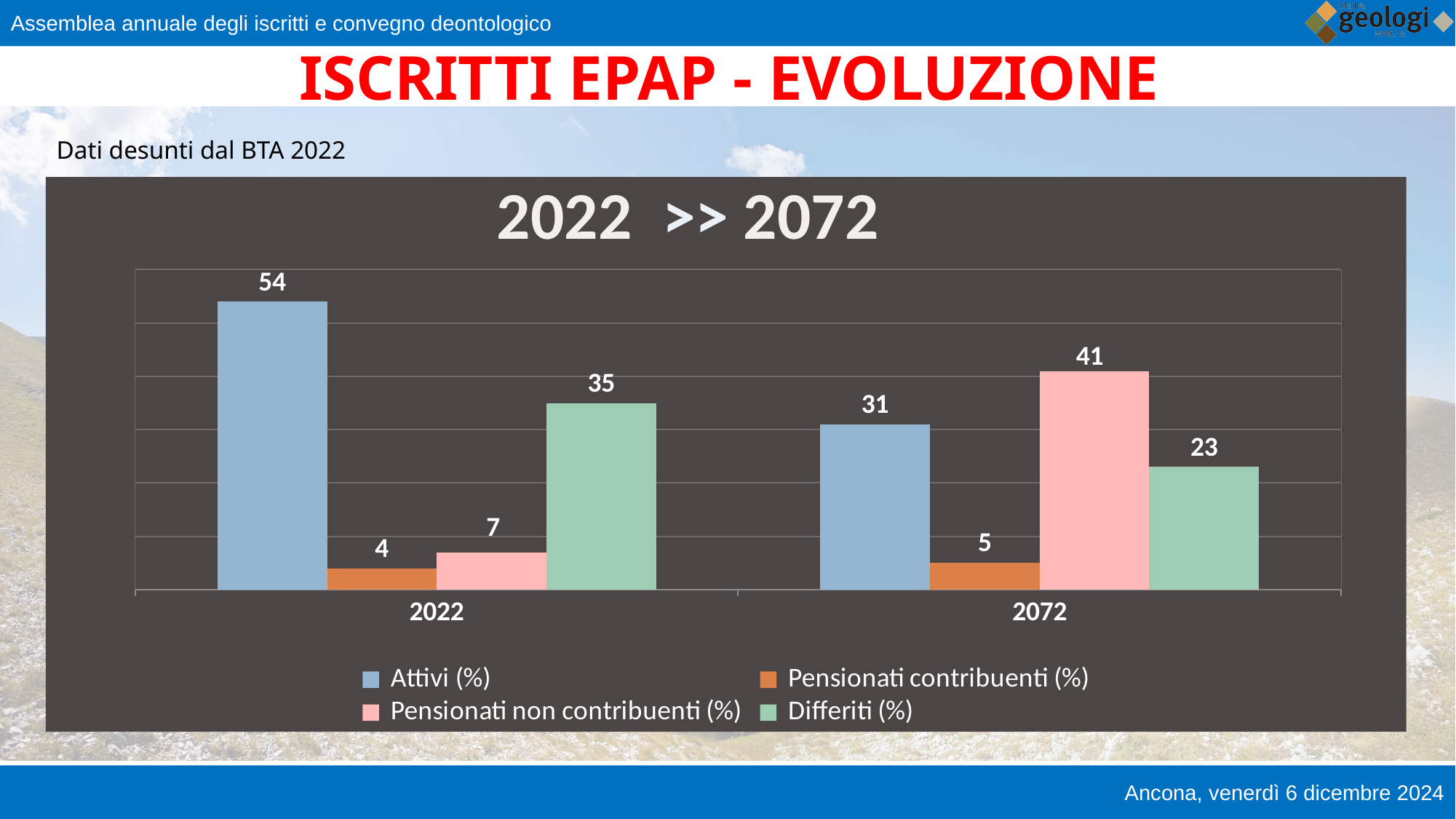
What is the value for Pensionati non contribuenti (%) in 2072? 41 What is the value for Attivi (%) in 2022? 54 Which series has the highest value in 2072? Pensionati non contribuenti (%) How many categories are shown on the x axis? 2 What is the title of the chart? 2022 >> 2072 How many series does the legend list? 4 What is the difference between the Attivi (%) value in 2022 and in 2072? 23 What kind of chart is shown on the slide? Bar chart Which is larger: Differiti (%) in 2022 or Differiti (%) in 2072? Differiti (%) in 2022 What is the value for Differiti (%) in 2022? 35 What is the value for Pensionati contribuenti (%) in 2072? 5 Which series has the lowest value in 2022? Pensionati contribuenti (%)